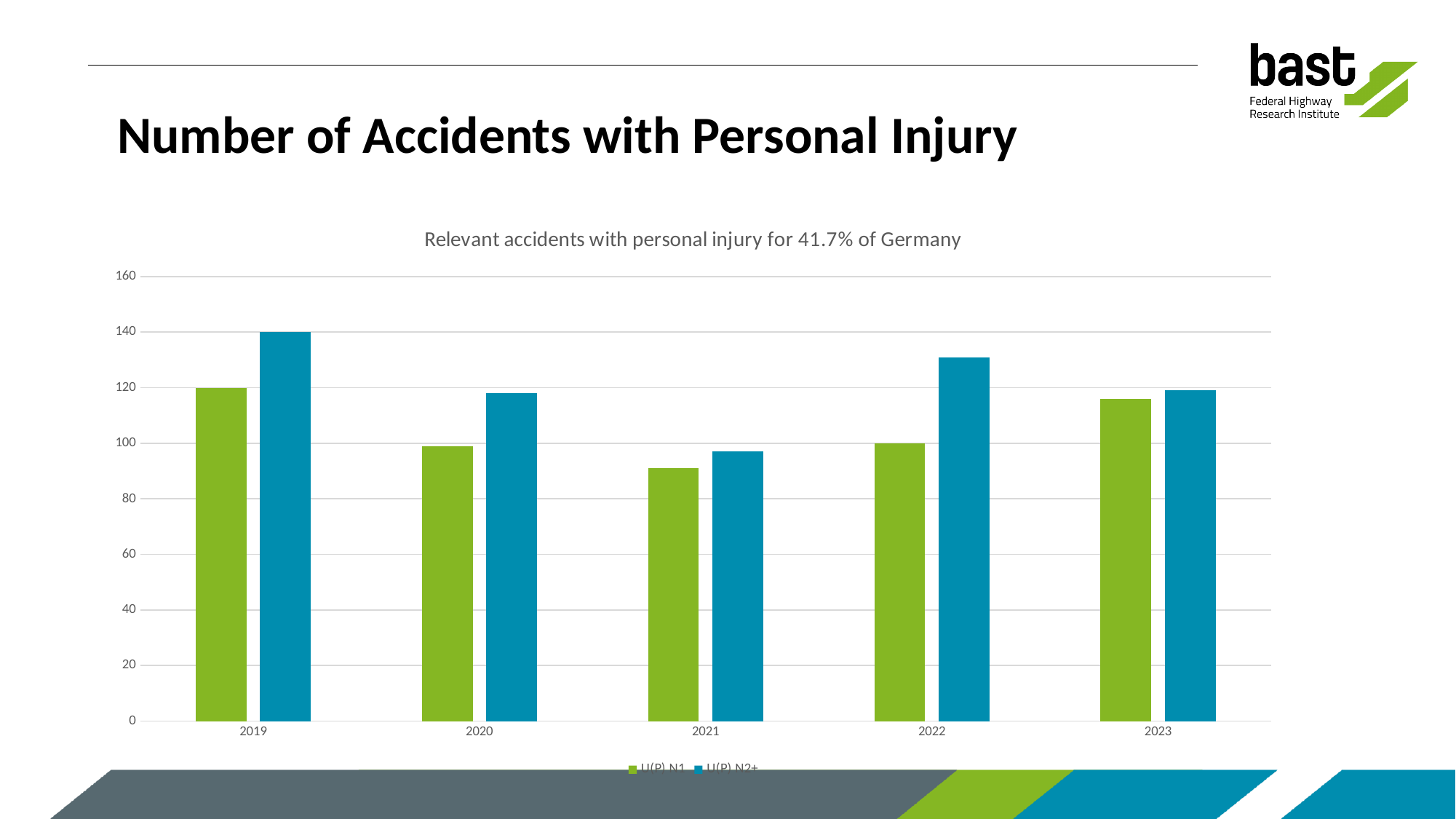
What type of chart is shown on the slide? Bar chart What is the difference between the blue bar and the green bar for 2019? 20 Which is larger: the blue bar for 2019 or the blue bar for 2022? The blue bar for 2019 In which year is the blue bar the highest? 2019 What is the value of the green bar for 2022? 100 How many years are shown on the x axis of the chart? 5 How many series does the chart's legend list? 2 Is the value of the green bar for 2021 greater or less than 100? less What is the value of the green bar for 2019? 120 What is the value of the blue bar for 2019? 140 Is the value of the blue bar for 2022 greater or less than 120? greater In which year is the green bar the lowest? 2021